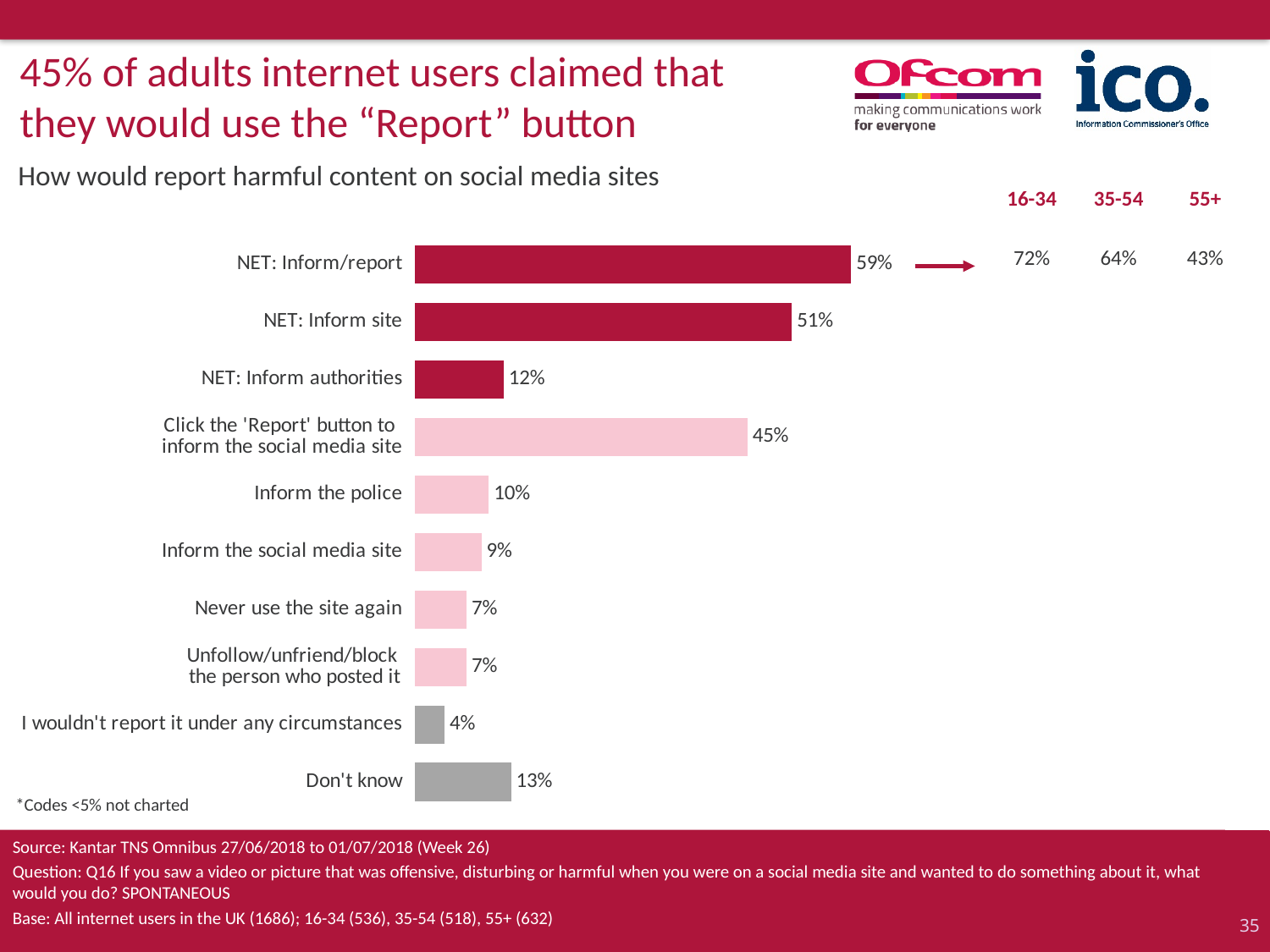
What percentage said they would inform the police? 10% What percentage of adult internet users said they would click the 'Report' button to inform the social media site? 45% Which is larger: 'Inform the police' or 'Inform the social media site'? Inform the police What is the value for 'Don't know'? 13% What is the difference between the 16-34 and 55+ values for 'NET: Inform/report'? 29% What is the difference between 'NET: Inform/report' and 'NET: Inform site'? 8% Which category has the lowest value in the chart? I wouldn't report it under any circumstances What kind of chart is shown on the slide? Bar chart Which category has the highest value in the chart? NET: Inform/report What is the 'NET: Inform/report' value for the 16-34 age group shown to the right of the chart? 72% What is the value for 'NET: Inform site'? 51% How many categories are plotted in the chart? 10